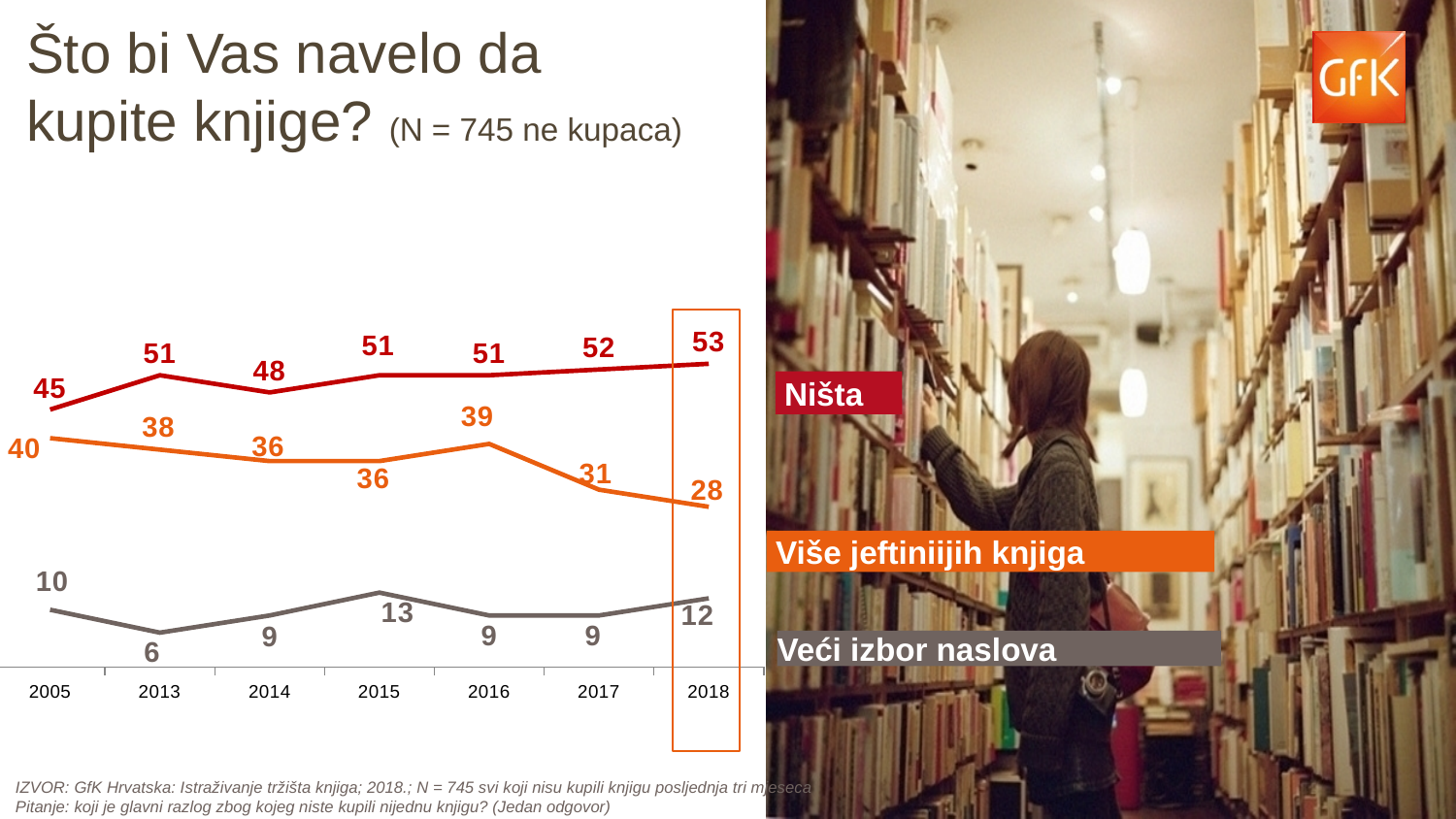
What is the value for "Ništa" in 2018? 53 In which year is the value for "Veći izbor naslova" highest? 2015 What kind of chart is shown on the slide? line chart How many years are shown on the x axis? 7 What is the value for "Veći izbor naslova" in 2013? 6 What is the value for "Više jeftiniijih knjiga" in 2016? 39 How many series are plotted on the chart? 3 Does the value for "Više jeftiniijih knjiga" rise or fall from 2016 to 2018? fall What is the difference between the "Ništa" value and the "Više jeftiniijih knjiga" value in 2018? 25 In which year is the value for "Više jeftiniijih knjiga" lowest? 2018 Which is larger in 2005: the value for "Ništa" or the value for "Više jeftiniijih knjiga"? Ništa Which series is drawn in red? Ništa